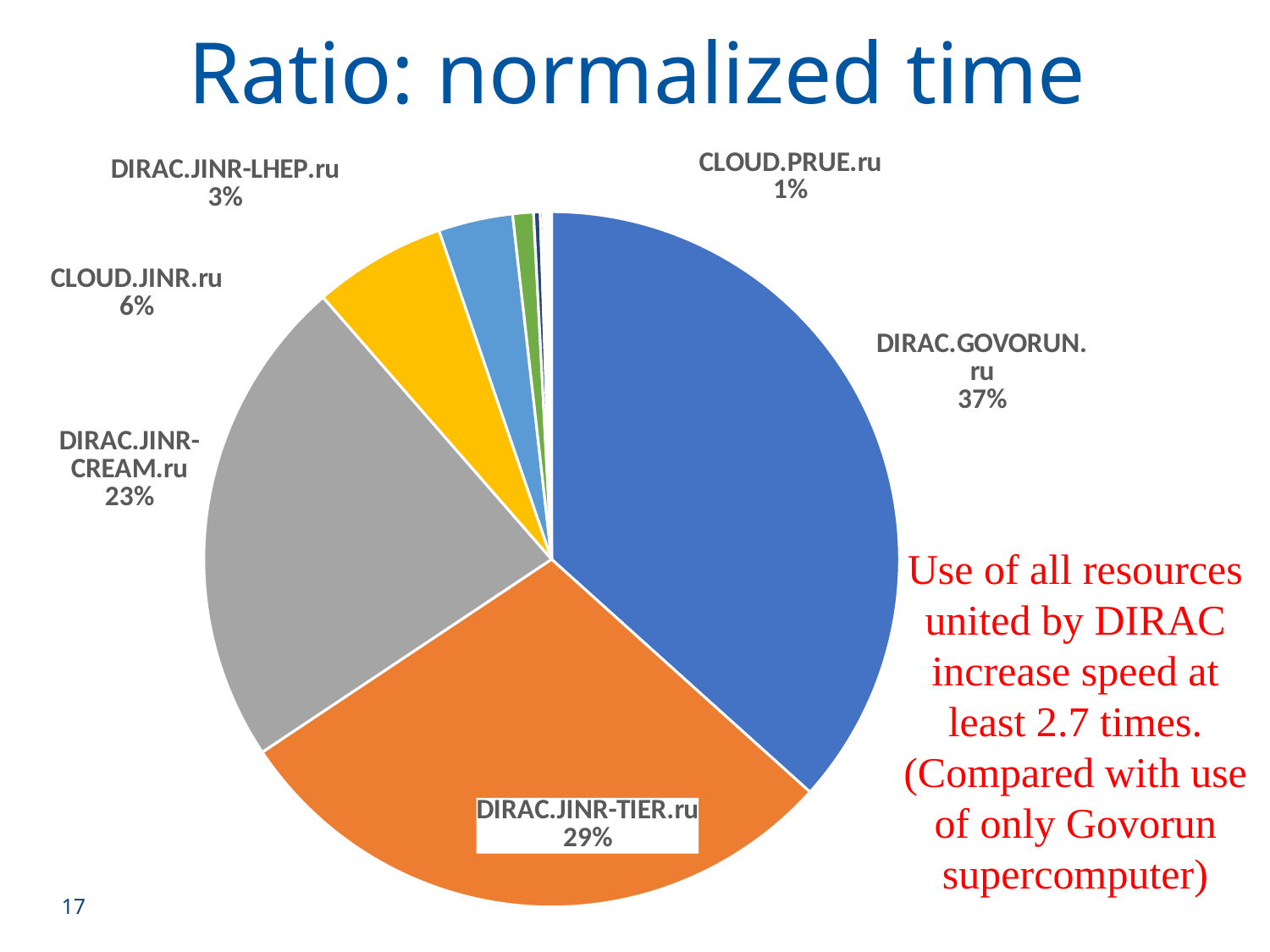
What share of the pie does DIRAC.GOVORUN.ru have? 37% What is the value shown for DIRAC.JINR-LHEP.ru? 3% What kind of chart is shown on the slide? Pie chart Which labelled category has the largest share of the pie? DIRAC.GOVORUN.ru What is the title of the slide containing the chart? Ratio: normalized time What is the value shown for CLOUD.PRUE.ru? 1% What is the value shown for DIRAC.JINR-CREAM.ru? 23% What is the difference in percentage points between DIRAC.GOVORUN.ru and DIRAC.JINR-TIER.ru? 8 What share of the pie does DIRAC.JINR-TIER.ru have? 29% Which is larger, the share for DIRAC.JINR-CREAM.ru or the share for CLOUD.JINR.ru? DIRAC.JINR-CREAM.ru Which labelled category has the smallest share of the pie? CLOUD.PRUE.ru What is the value shown for CLOUD.JINR.ru? 6%